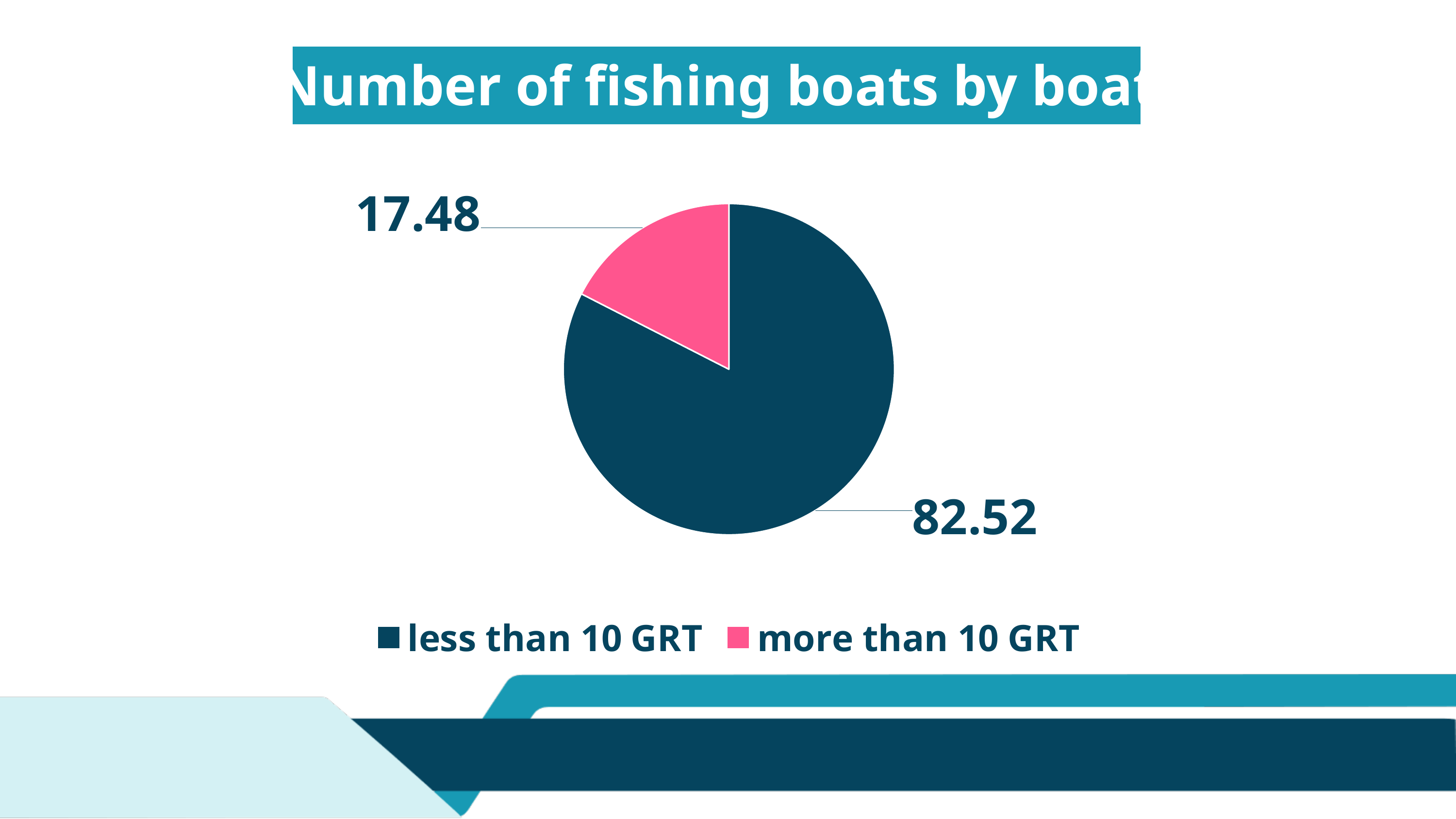
What is the total of the two values shown on the pie chart? 100 What colour is the slice for 'less than 10 GRT'? dark blue What is the difference between the values for 'less than 10 GRT' and 'more than 10 GRT'? 65.04 How many categories does the pie chart show? 2 Which category has the largest slice of the pie? less than 10 GRT What kind of chart is shown on the slide? pie chart What colour is the slice for 'more than 10 GRT'? pink How many entries does the legend list? 2 What is the value for 'less than 10 GRT'? 82.52 Which category has the smallest slice of the pie? more than 10 GRT Which is larger: the value for 'less than 10 GRT' or 'more than 10 GRT'? less than 10 GRT What is the value for 'more than 10 GRT'? 17.48